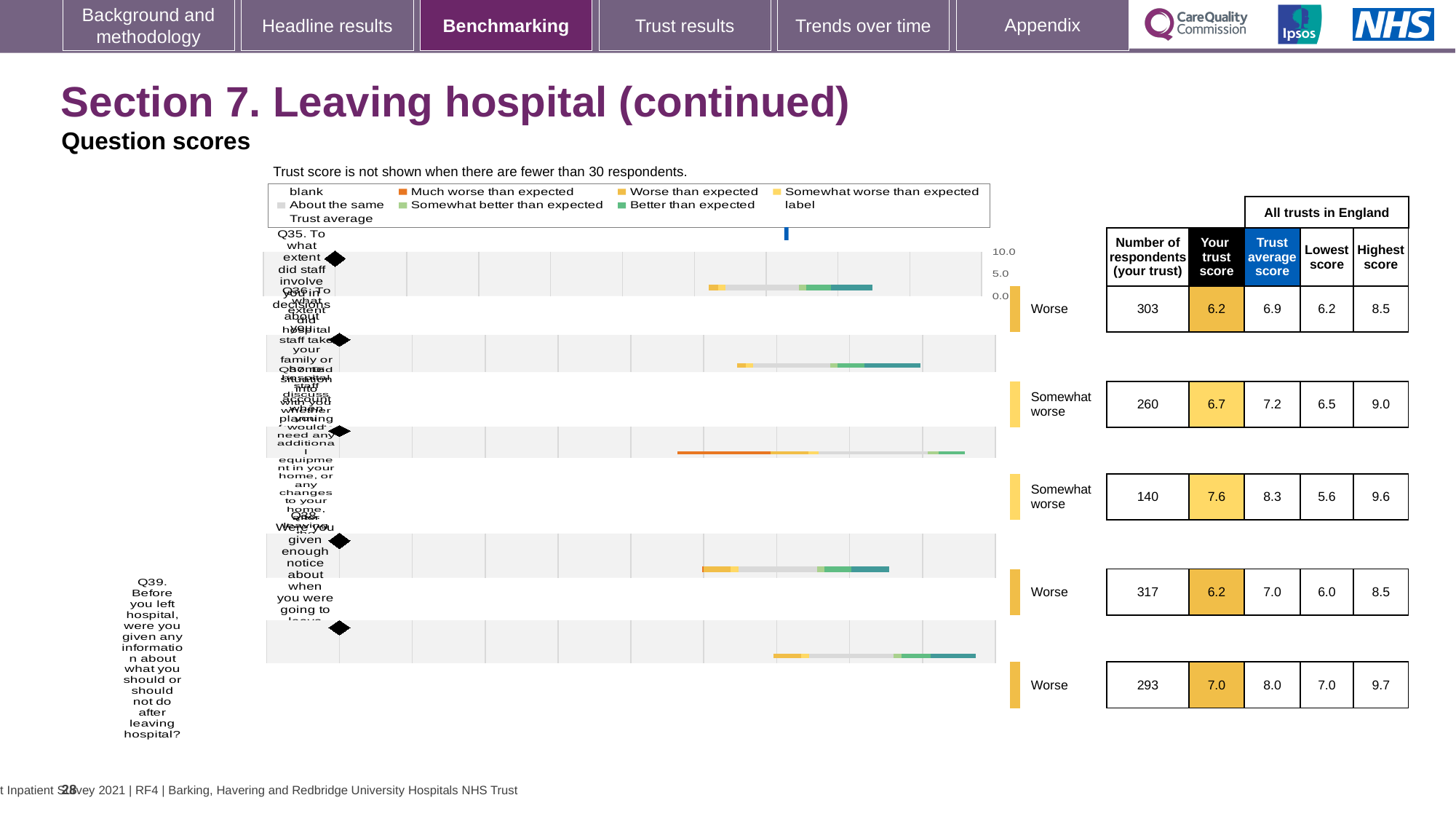
What is the number of respondents for Q39 (information about what you should or should not do after leaving hospital)? 293 What is the number of respondents for Q35 (staff involving you in decisions about leaving hospital), the first row of the table? 303 What is the trust score for Q39 (information about what you should or should not do after leaving hospital)? 7.0 Which row of the table has the lowest number of respondents? Q37 (140 respondents) Is the trust score for Q39 larger or smaller than the trust score for Q35? larger What is the trust score for Q35, the first row of the table? 6.2 Which row of the table has the highest number of respondents? Q38 (317 respondents) What is the highest score across all trusts in England for Q39? 9.7 How many questions are shown in the chart and table on this slide? 5 What is the trust average score for Q39 (information about what you should or should not do after leaving hospital)? 8.0 What is the difference between the trust average score and your trust score for Q39? 1.0 What kind of chart is used to show the question scores on this slide? bar chart